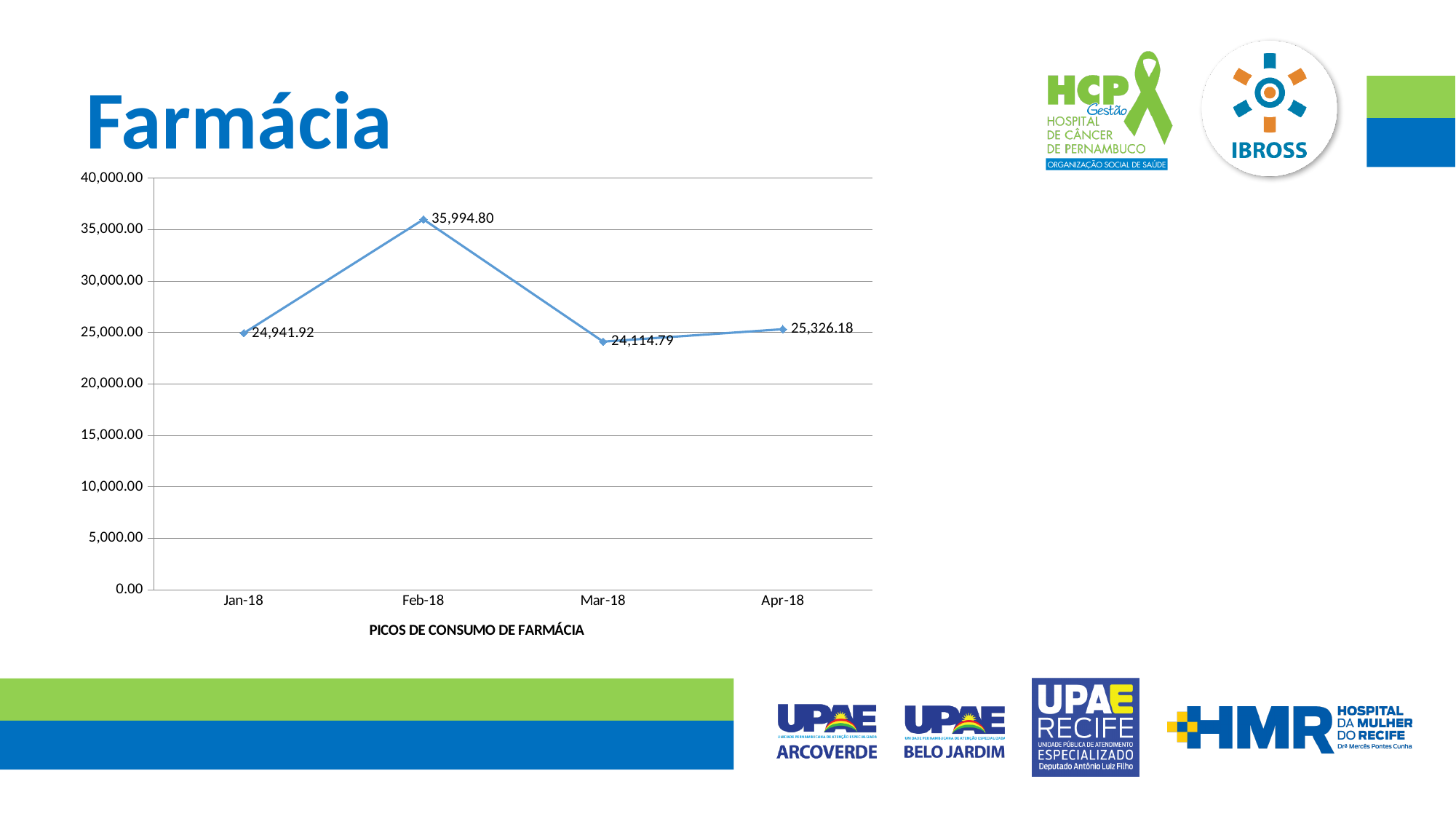
What is the value for Apr-18? 25,326.18 What is the difference between the values for Feb-18 and Jan-18? 11,052.88 Which month has the highest value? Feb-18 Which is larger, the value for Jan-18 or the value for Mar-18? Jan-18 Which month has the lowest value? Mar-18 What is the legend entry shown below the chart? PICOS DE CONSUMO DE FARMÁCIA What kind of chart is shown on the slide? Line chart What is the difference between the values for Apr-18 and Mar-18? 1,211.39 How many months are plotted on the chart? 4 What is the value for Mar-18? 24,114.79 What is the value for Feb-18? 35,994.80 What is the value for Jan-18? 24,941.92